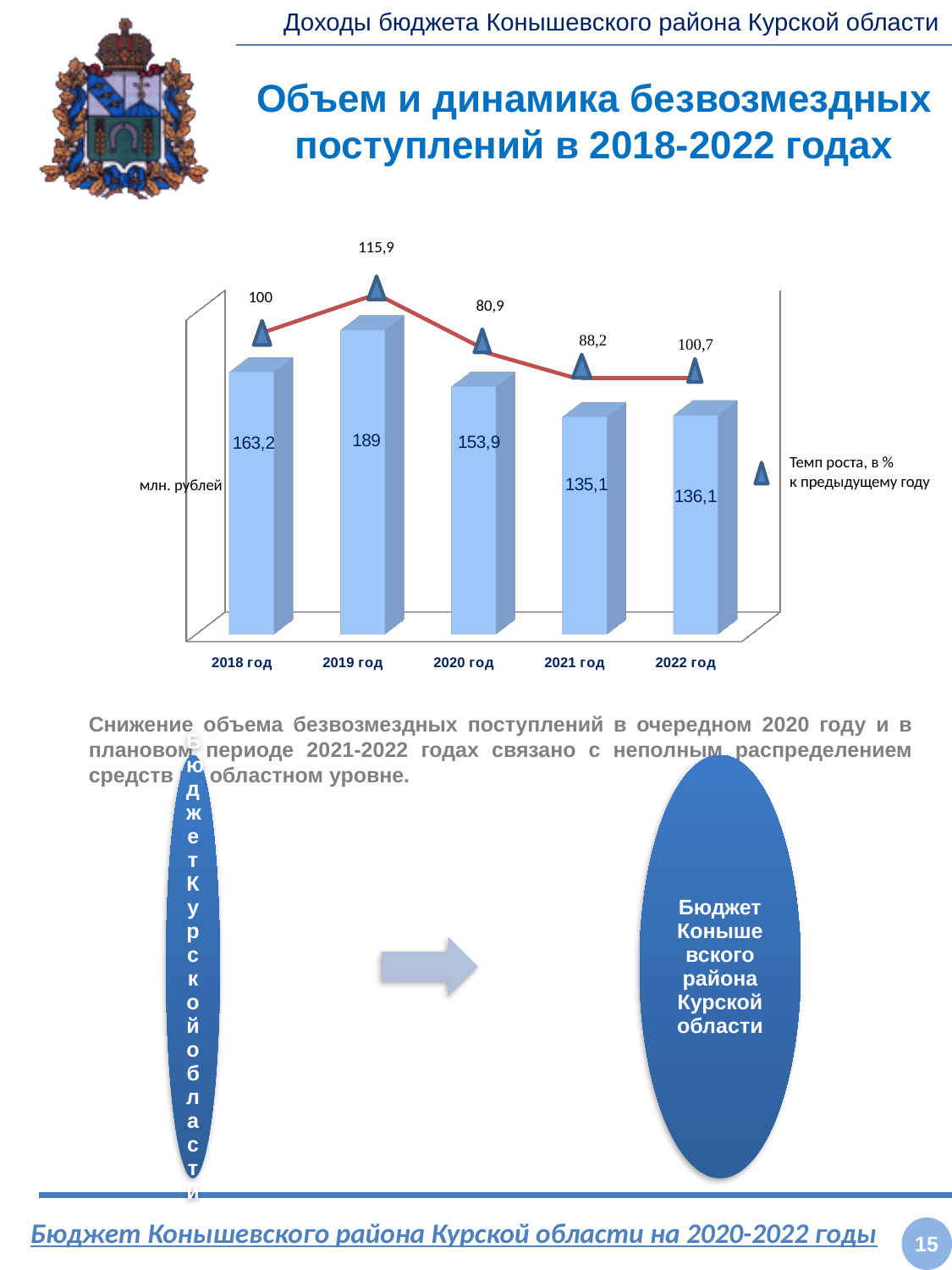
Which year has the lowest темп роста (%)? 2020 год What is the темп роста (%) shown for 2020 год? 80,9 What is the темп роста (%) shown for 2022 год? 100,7 What kind of chart is used to show the безвозмездные поступления values in млн. рублей? Bar chart What is the difference in безвозмездные поступления (млн. рублей) between 2019 год and 2018 год? 25,8 Do the безвозмездные поступления values rise or fall from 2019 год to 2021 год? Fall What is the value of безвозмездные поступления (млн. рублей) for 2021 год? 135,1 Which year has the lowest value of безвозмездные поступления (млн. рублей)? 2021 год How many years are shown on the x axis of the chart? 5 What is the value of безвозмездные поступления (млн. рублей) for 2019 год? 189 Which is larger, the безвозмездные поступления value for 2022 год or for 2021 год? 2022 год Which year has the highest value of безвозмездные поступления (млн. рублей)? 2019 год